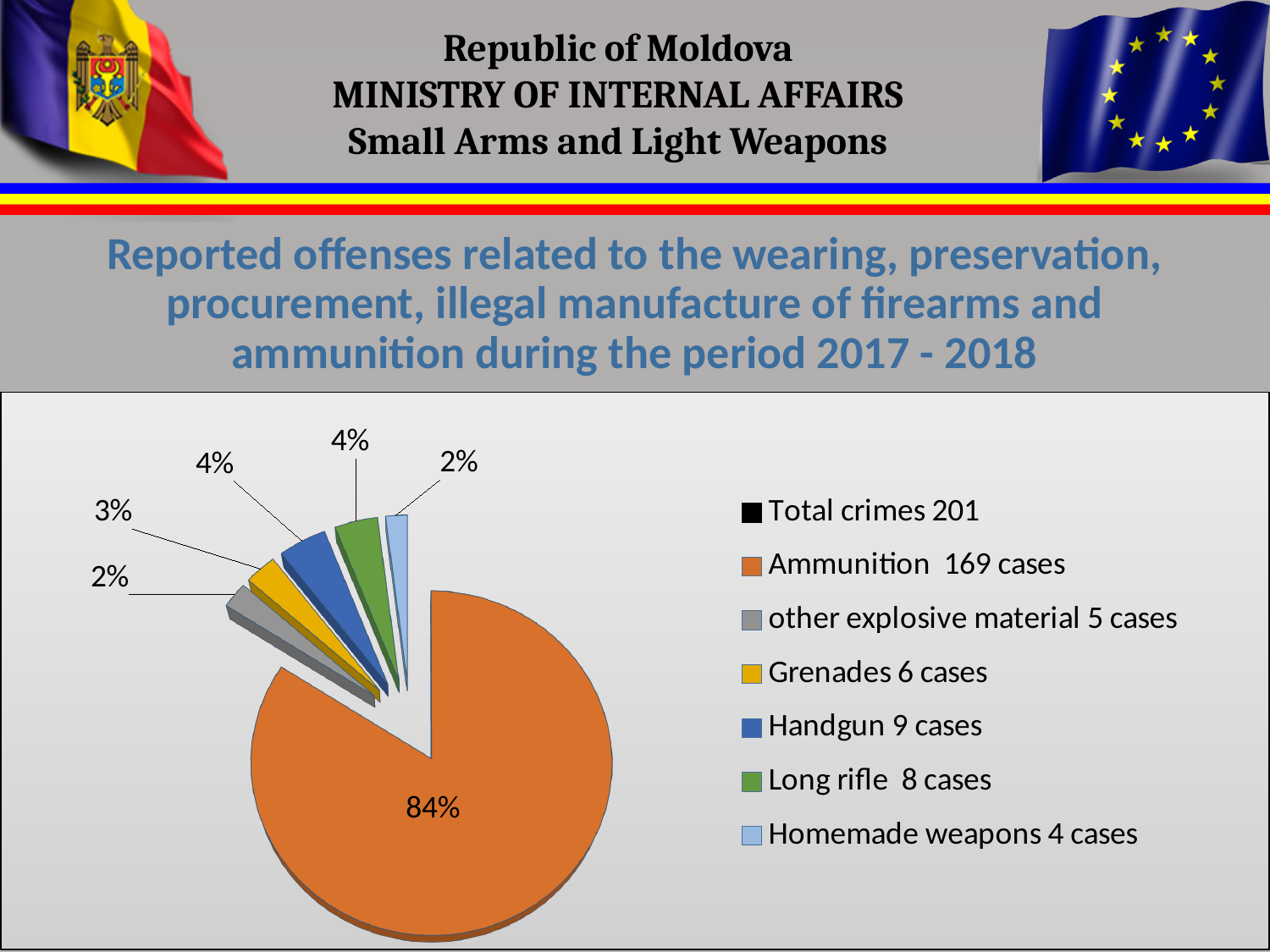
What share of the pie does the Ammunition slice represent? 84% Which category has the largest slice of the pie? Ammunition According to the legend, which category has the fewest cases? Homemade weapons According to the legend, how many cases are attributed to other explosive material? 5 cases How many entries does the chart legend list? 7 What type of chart is shown on the slide? Pie chart What percentage label is shown for the Homemade weapons slice? 2% According to the legend, which has more cases: Handgun or Long rifle? Handgun According to the legend, how many more cases are attributed to Ammunition than to Grenades? 163 What percentage label is shown for the Handgun slice? 4% According to the legend, how many cases are attributed to Handgun? 9 cases What percentage label is shown for the Grenades slice? 3%